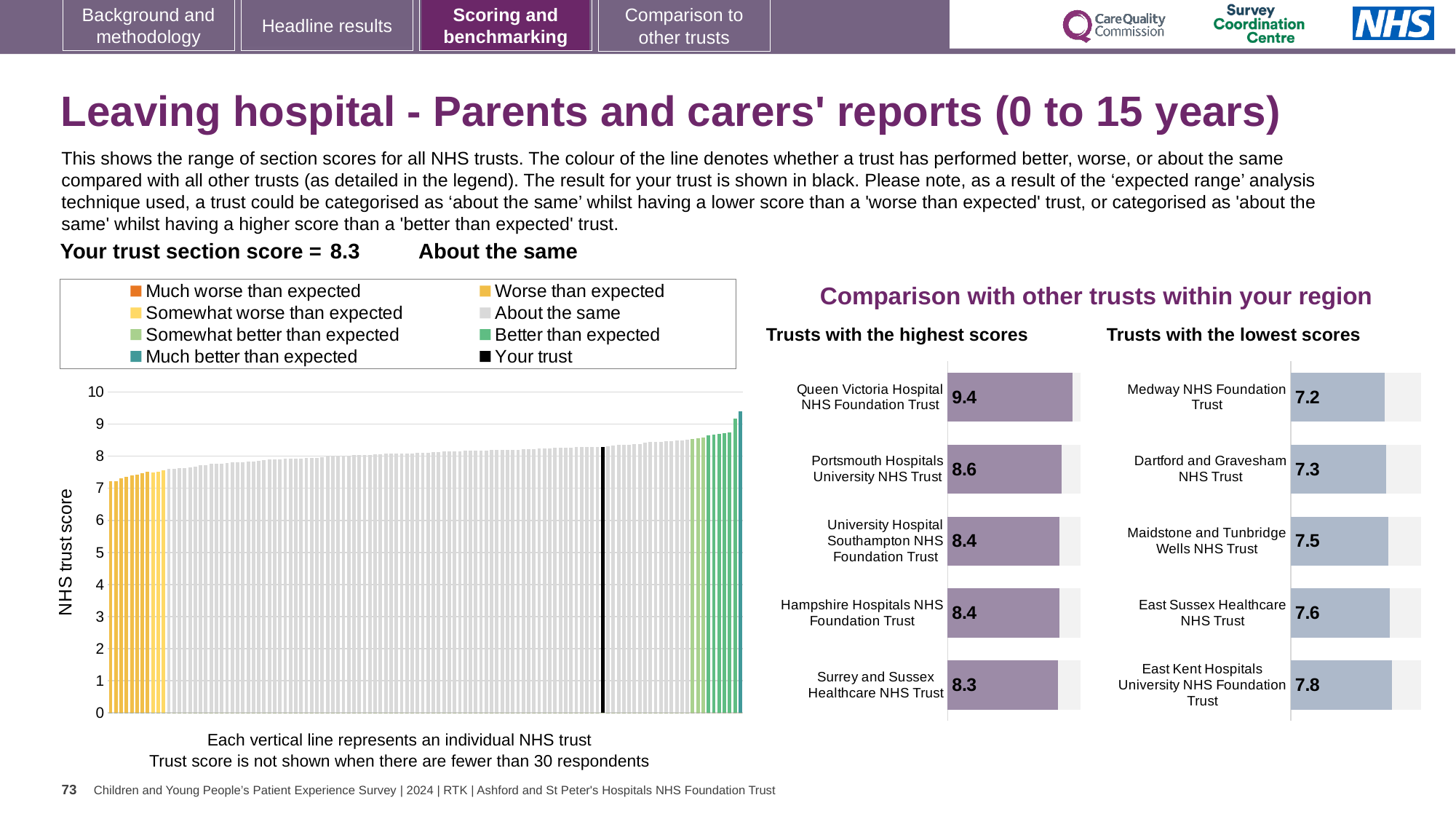
In the 'Trusts with the lowest scores' chart, which has the larger score: Dartford and Gravesham NHS Trust or East Sussex Healthcare NHS Trust? East Sussex Healthcare NHS Trust In the 'Trusts with the highest scores' chart, what is the score for Queen Victoria Hospital NHS Foundation Trust? 9.4 In the 'Trusts with the lowest scores' chart, what is the difference between the scores of East Kent Hospitals University NHS Foundation Trust and Medway NHS Foundation Trust? 0.6 In the main chart on the left, do the trust scores rise or fall from left to right? rise What type of chart is the 'Trusts with the lowest scores' chart? bar chart How many trusts are shown in the 'Trusts with the highest scores' chart? 5 In the 'Trusts with the highest scores' chart, what is the difference between the scores of Queen Victoria Hospital NHS Foundation Trust and Portsmouth Hospitals University NHS Trust? 0.8 In the 'Trusts with the highest scores' chart, which trust has the highest score? Queen Victoria Hospital NHS Foundation Trust In the main chart on the left, what is the section score for your trust (the black bar)? 8.3 In the 'Trusts with the lowest scores' chart, what is the score for Medway NHS Foundation Trust? 7.2 How many entries does the legend of the main chart on the left list? 8 In the 'Trusts with the lowest scores' chart, which trust has the lowest score? Medway NHS Foundation Trust